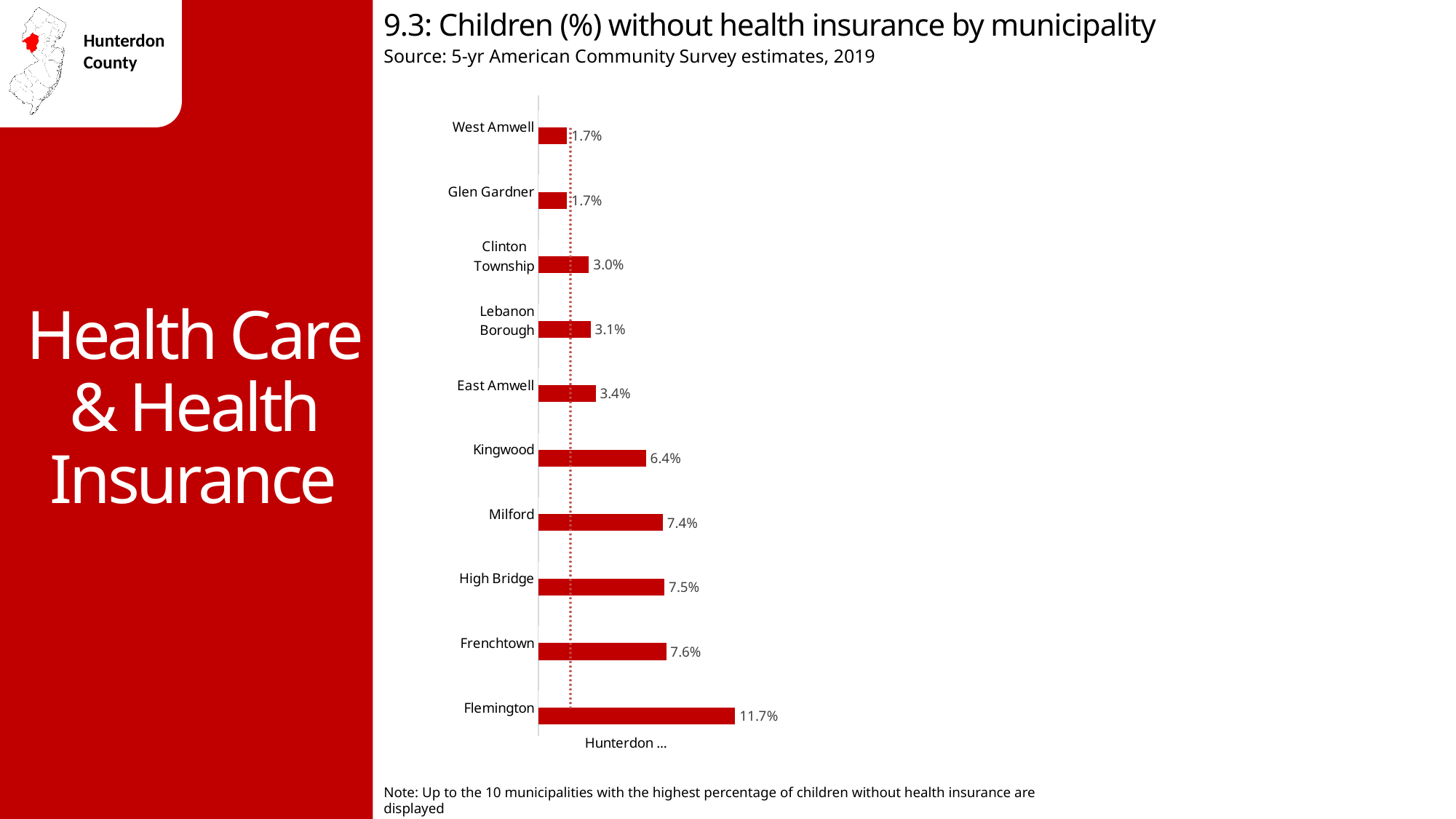
What percentage is shown for Clinton Township? 3.0% What is the difference in percentage points between Kingwood and East Amwell? 3.0 Which has a higher value, Kingwood or East Amwell? Kingwood How many municipalities are shown on the chart? 10 Do the values increase or decrease going from the top of the chart to the bottom? Increase What is the difference in percentage points between Flemington and Frenchtown? 4.1 Which municipality has the highest percentage of children without health insurance? Flemington What kind of chart is shown on the slide? Bar chart What percentage of children in Flemington are without health insurance? 11.7% What is the value for High Bridge? 7.5% What is the value shown for Kingwood? 6.4% Which two municipalities share the lowest value on the chart? West Amwell and Glen Gardner